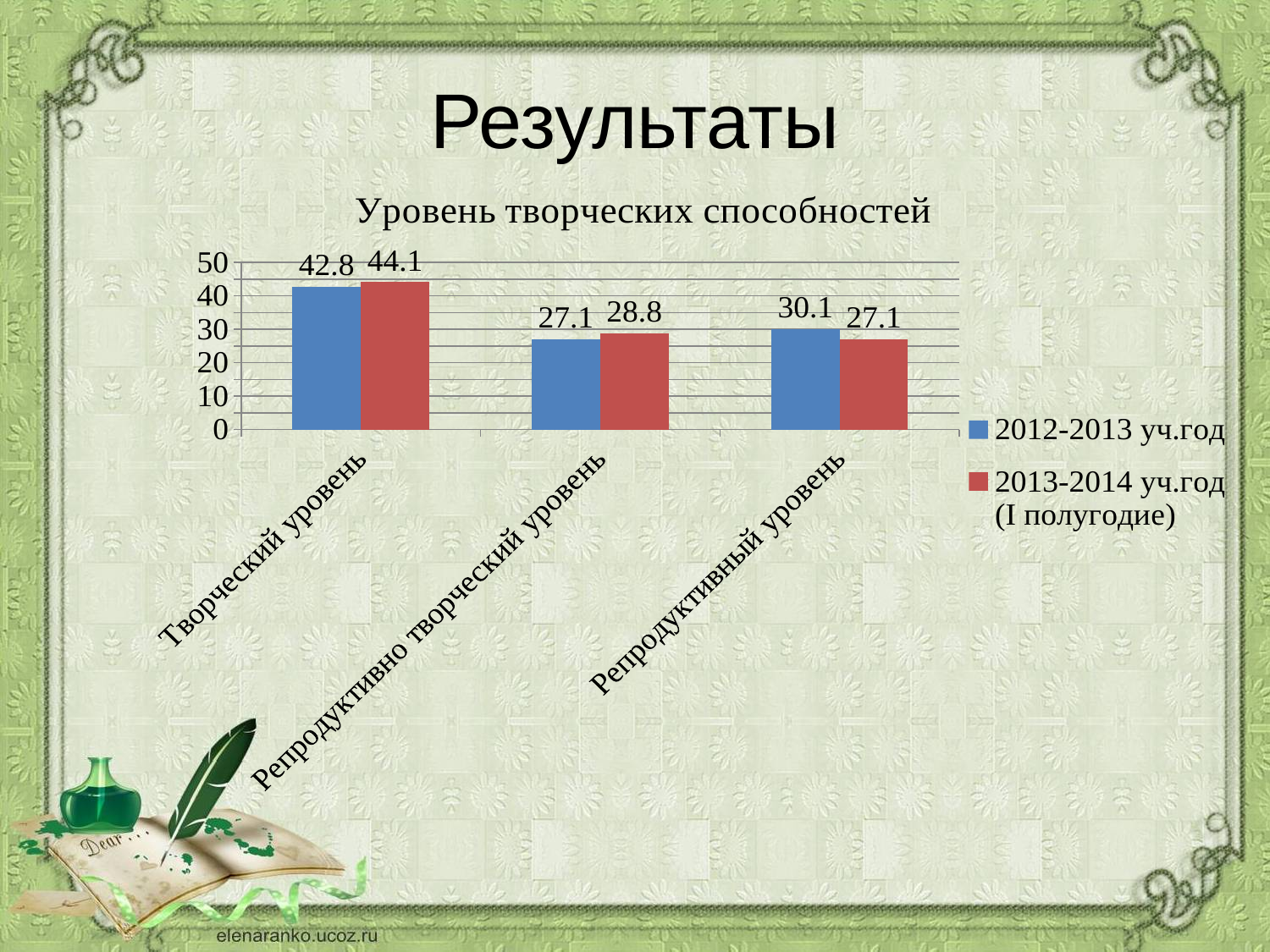
For Репродуктивный уровень, which series has the larger value: 2012-2013 уч.год or 2013-2014 уч.год (I полугодие)? 2012-2013 уч.год Which category has the lowest value in the 2012-2013 уч.год series? Репродуктивно творческий уровень What is the difference between the 2013-2014 уч.год (I полугодие) and 2012-2013 уч.год values for Творческий уровень? 1.3 What kind of chart is shown on the slide? bar chart What is the value for Репродуктивно творческий уровень in the 2013-2014 уч.год (I полугодие) series? 28.8 What is the title of the chart? Уровень творческих способностей What is the value for Творческий уровень in the 2012-2013 уч.год series? 42.8 What is the value for Репродуктивный уровень in the 2012-2013 уч.год series? 30.1 Which category has the highest value in the 2013-2014 уч.год (I полугодие) series? Творческий уровень Is the value for Репродуктивно творческий уровень in the 2012-2013 уч.год series greater or less than 30? less How many series does the legend list? 2 How many categories are shown on the x axis? 3